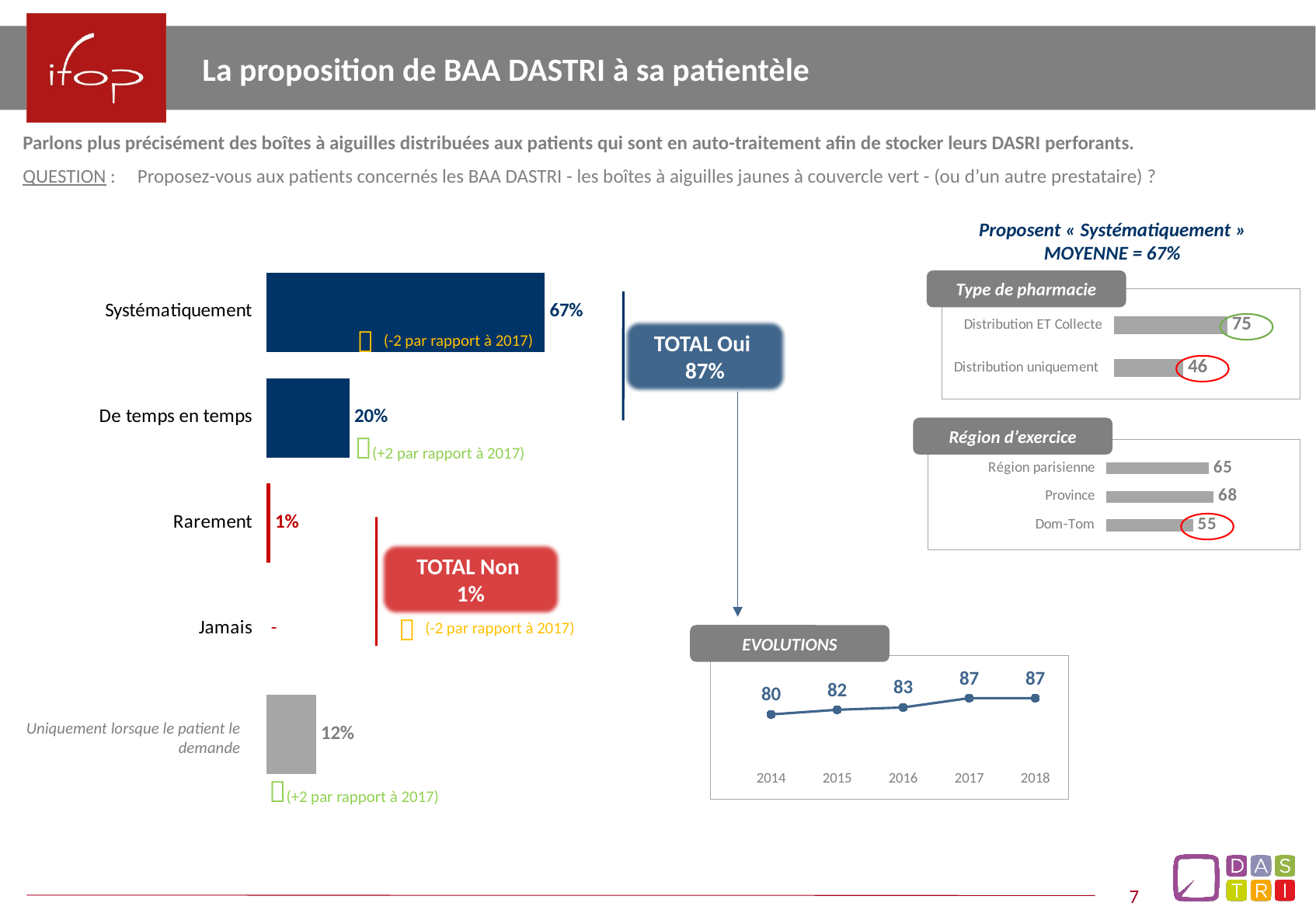
In the main bar chart on the left, what is the difference between "Systématiquement" and "De temps en temps"? 47% In the "Type de pharmacie" chart, what is the value for "Distribution uniquement"? 46 In the "Région d'exercice" chart, what is the difference between "Province" and "Dom-Tom"? 13 In the main bar chart on the left, which category has the highest value? Systématiquement In the "EVOLUTIONS" line chart, do the values rise or fall from 2014 to 2018? Rise In the "Région d'exercice" chart, what is the value for "Province"? 68 In the main bar chart on the left, what is the value for "Systématiquement"? 67% In the "EVOLUTIONS" line chart, what is the value for 2016? 83 In the "Région d'exercice" chart, which category has the lowest value? Dom-Tom In the main bar chart on the left, what is the value for "De temps en temps"? 20% In the "Type de pharmacie" chart, which category has the higher value, "Distribution ET Collecte" or "Distribution uniquement"? Distribution ET Collecte In the main bar chart on the left, what kind of chart is used? Bar chart